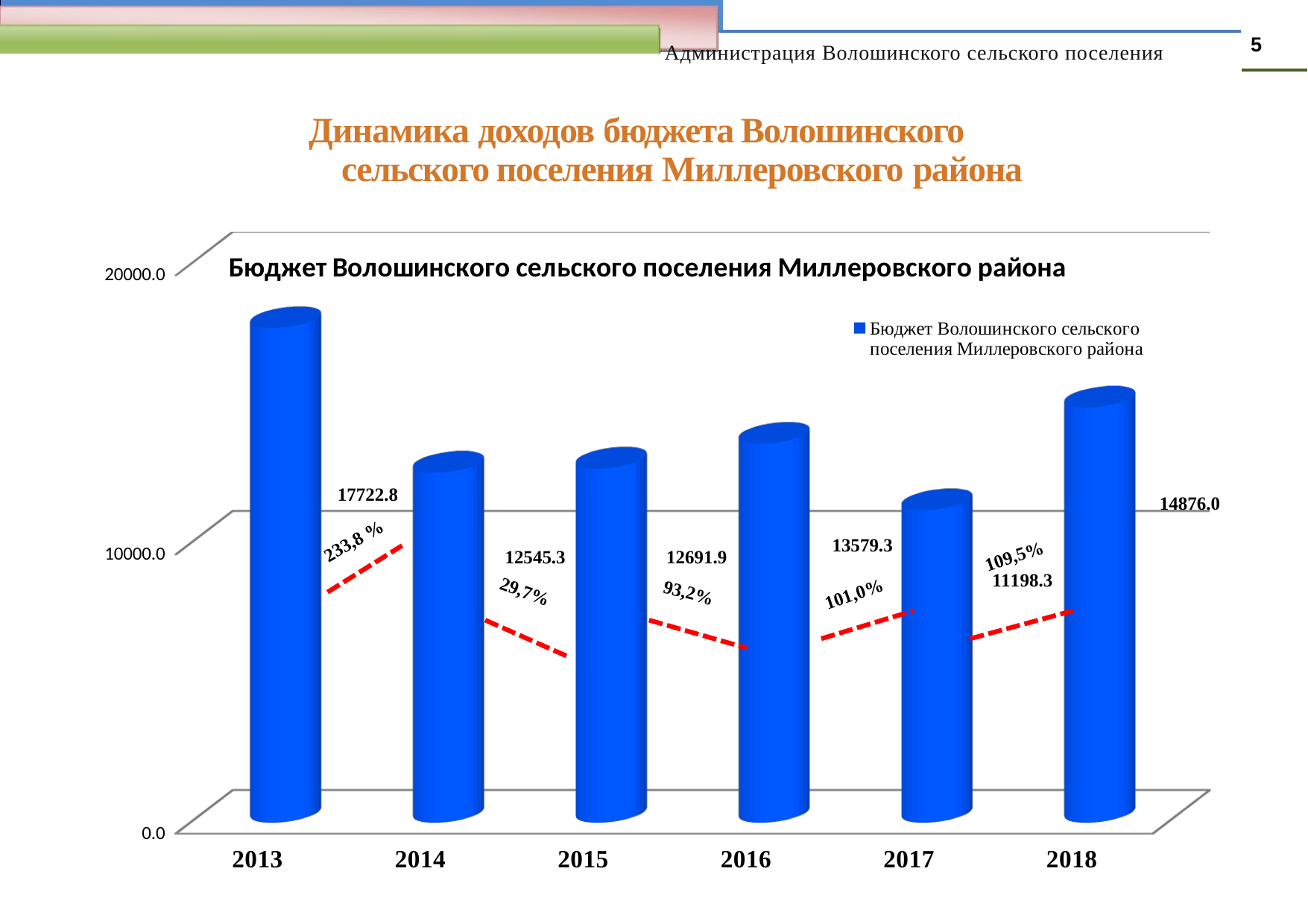
How many series does the legend list? 1 What kind of chart is shown? bar chart Which year has the lowest value? 2017 How many years are shown on the x axis? 6 What is the value for 2018? 14876.0 Which year has the highest value? 2013 What is the value for 2017? 11198.3 What is the value for 2013? 17722.8 What is the difference between the values for 2013 and 2014? 5177.5 Is the value for 2015 greater or less than 10000.0? greater Which is larger, the value for 2016 or the value for 2018? 2018 What is the value for 2016? 13579.3